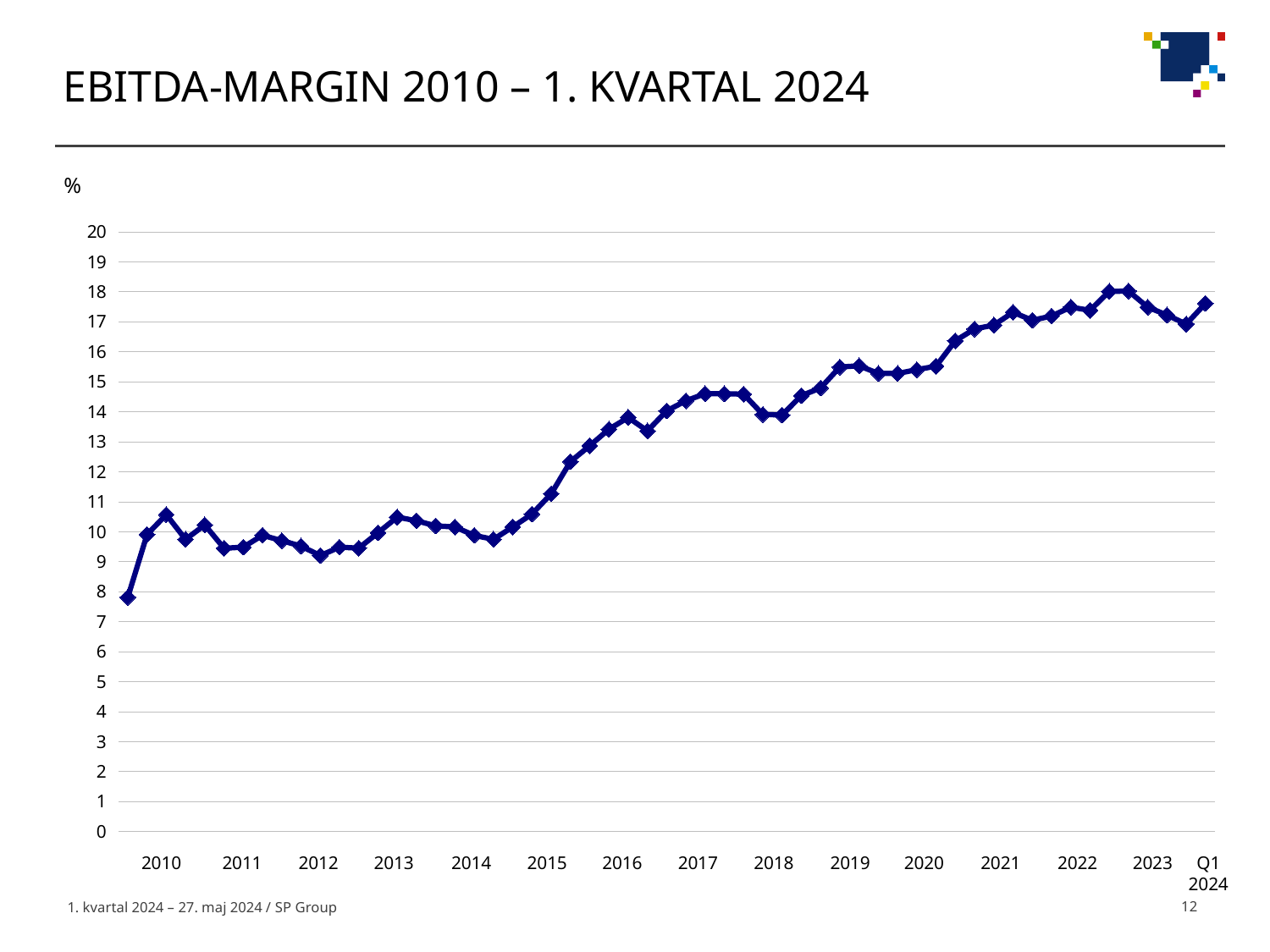
Is the value at the start of 2012 greater or less than 10? less Is the value for Q1 2024 greater or less than 17? greater In which year does the line reach its lowest value? 2010 Is the first plotted value in 2010 greater or less than 9? less Overall, do the values rise or fall from 2010 to Q1 2024? rise What is the title of the chart? EBITDA-MARGIN 2010 – 1. KVARTAL 2024 What unit is shown on the y axis of the chart? % How many labels are shown on the x axis? 15 Which is higher, the value at Q1 2024 or the first value in 2010? Q1 2024 What kind of chart is shown on the slide? line chart